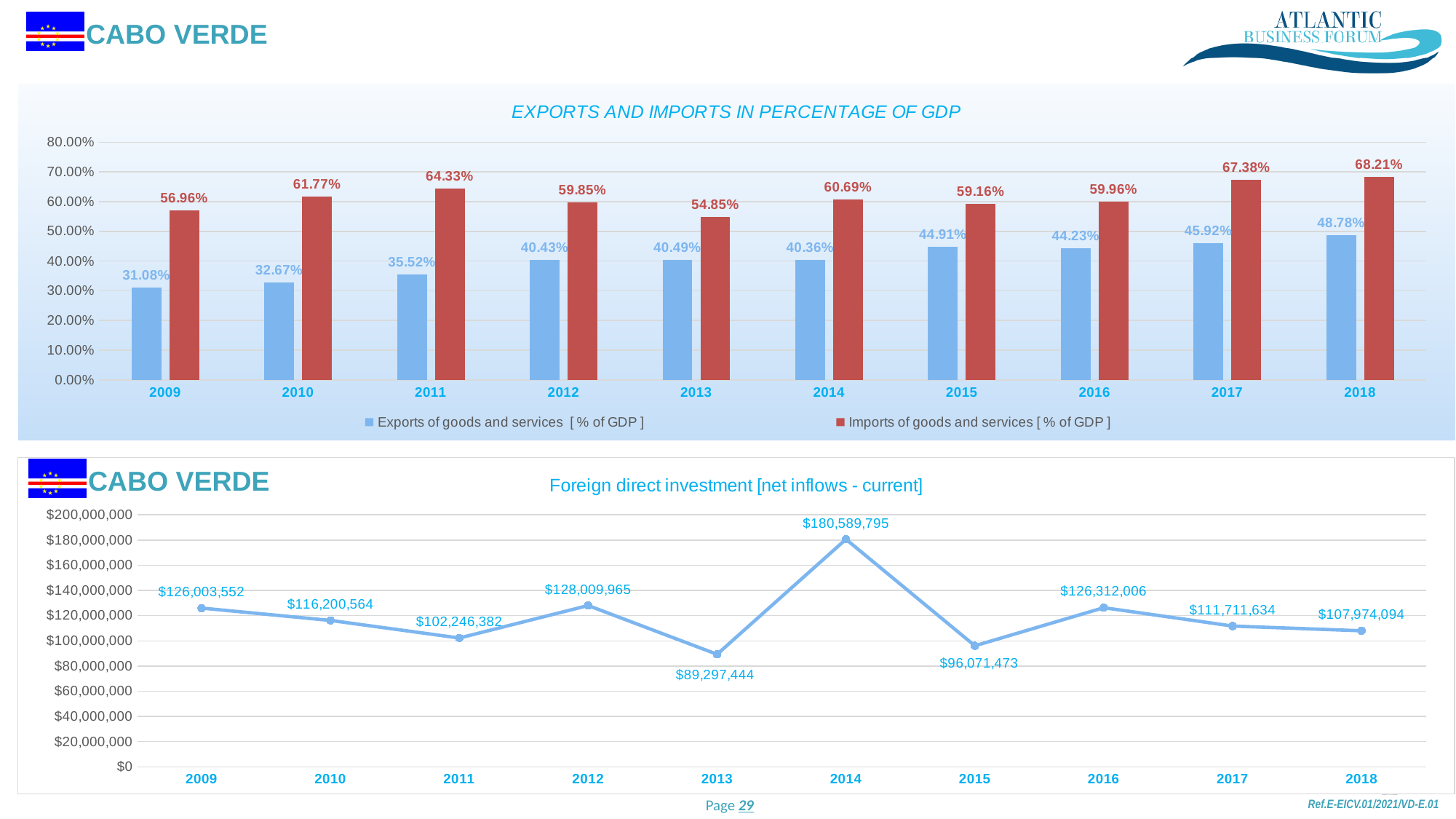
In the 'EXPORTS AND IMPORTS IN PERCENTAGE OF GDP' chart, what is the difference between Imports and Exports in 2018? 19.43% In the 'EXPORTS AND IMPORTS IN PERCENTAGE OF GDP' chart, what is the value of Exports of goods and services for 2012? 40.43% What kind of chart is the 'EXPORTS AND IMPORTS IN PERCENTAGE OF GDP' chart? Bar chart How many years are plotted in the 'Foreign direct investment [net inflows - current]' chart? 10 In the 'Foreign direct investment [net inflows - current]' chart, which year has the lowest value? 2013 In the 'Foreign direct investment [net inflows - current]' chart, which is larger, the value for 2010 or the value for 2017? 2010 In the 'Foreign direct investment [net inflows - current]' chart, what is the value for 2016? $126,312,006 In the 'EXPORTS AND IMPORTS IN PERCENTAGE OF GDP' chart, what is the value of Imports of goods and services for 2013? 54.85% In the 'Foreign direct investment [net inflows - current]' chart, what is the difference between the 2014 and 2013 values? $91,292,351 In the 'EXPORTS AND IMPORTS IN PERCENTAGE OF GDP' chart, how many series does the legend list? 2 In the 'EXPORTS AND IMPORTS IN PERCENTAGE OF GDP' chart, which year has the lowest Exports of goods and services value? 2009 In the 'EXPORTS AND IMPORTS IN PERCENTAGE OF GDP' chart, which year has the highest Imports of goods and services value? 2018